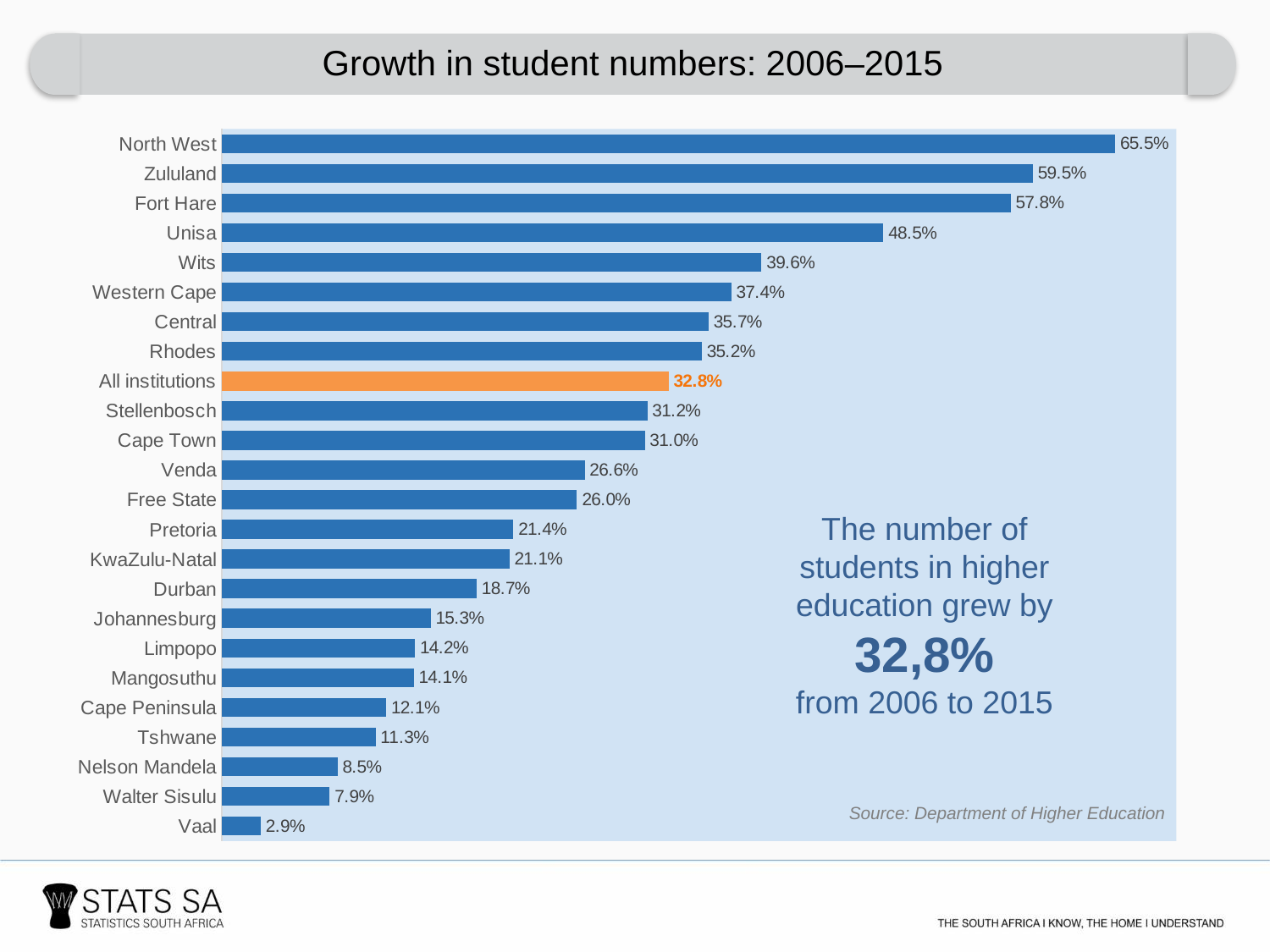
Which bar is highlighted in orange? All institutions Which institution has the highest growth in student numbers? North West Which has a higher growth in student numbers, Fort Hare or Unisa? Fort Hare How many bars are shown in the chart? 24 What kind of chart is shown on the slide? Bar chart What is the value shown for All institutions? 32.8% Which institution has the lowest growth in student numbers? Vaal Which has a higher growth in student numbers, Durban or Johannesburg? Durban What is the growth in student numbers for North West? 65.5% What is the difference between the growth for North West and Vaal? 62.6% What is the growth in student numbers for Stellenbosch? 31.2% What is the difference between the growth for Unisa and Wits? 8.9%